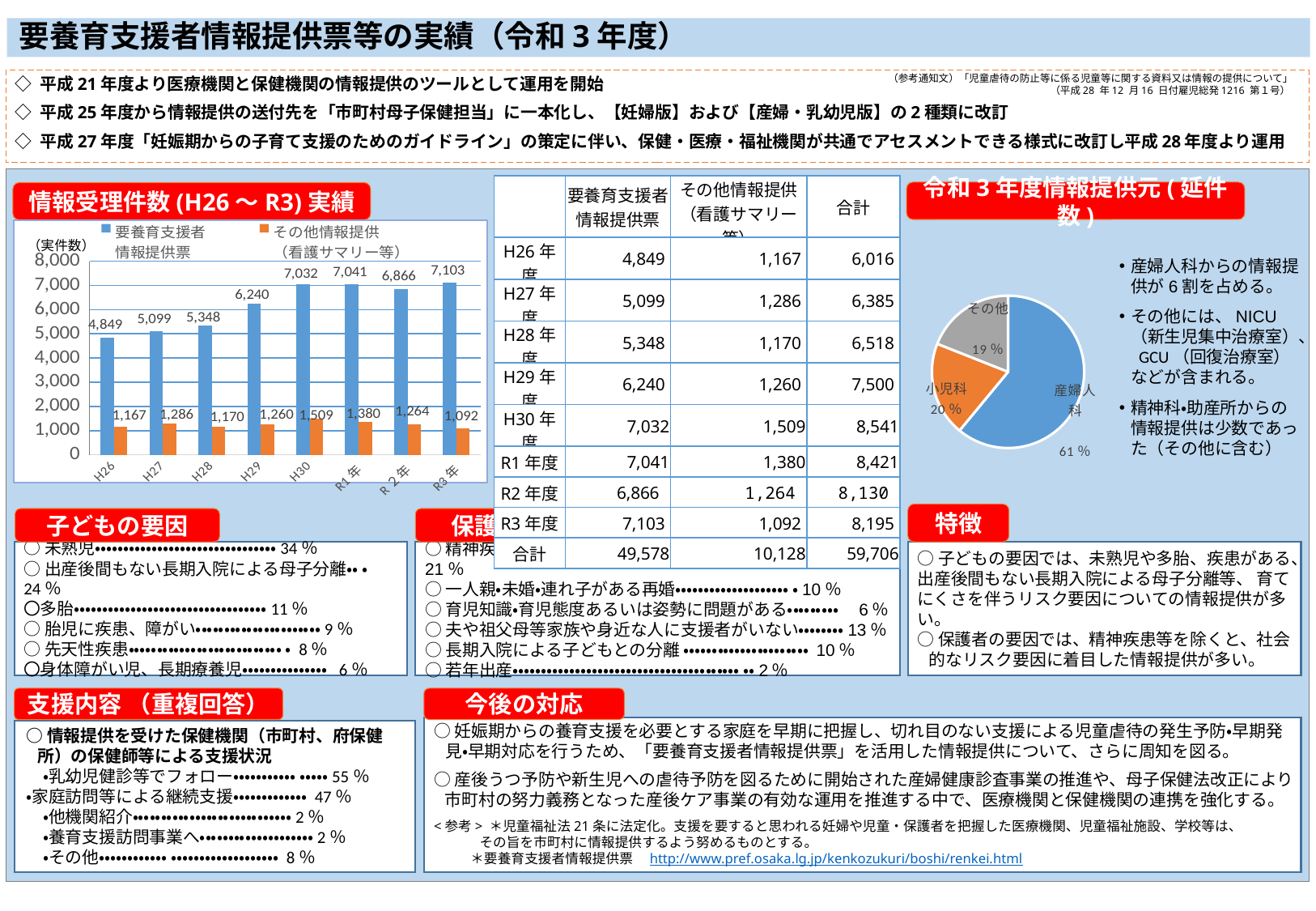
What kind of chart is the 情報受理件数 (H26～R3) 実績 chart? bar chart In the bar chart titled 情報受理件数 (H26～R3) 実績, which year has the lowest value for その他情報提供（看護サマリー等）? R3年 In the bar chart titled 情報受理件数 (H26～R3) 実績, what is the value of その他情報提供（看護サマリー等） for H30? 1,509 In the pie chart titled 令和3年度情報提供元(延件数), which category has the smallest share? その他 In the bar chart titled 情報受理件数 (H26～R3) 実績, which is larger: the 要養育支援者情報提供票 value for R1年 or for R2年? R1年 In the pie chart titled 令和3年度情報提供元(延件数), what share does 産婦人科 have? 61% In the bar chart titled 情報受理件数 (H26～R3) 実績, which year has the highest value for 要養育支援者情報提供票? R3年 In the bar chart titled 情報受理件数 (H26～R3) 実績, how many years are shown on the x axis? 8 In the bar chart titled 情報受理件数 (H26～R3) 実績, how many series does the legend list? 2 In the bar chart titled 情報受理件数 (H26～R3) 実績, what is the value of 要養育支援者情報提供票 for H26? 4,849 In the bar chart titled 情報受理件数 (H26～R3) 実績, what is the difference between the 要養育支援者情報提供票 values for H29 and H28? 892 In the pie chart titled 令和3年度情報提供元(延件数), how many slices are there? 3